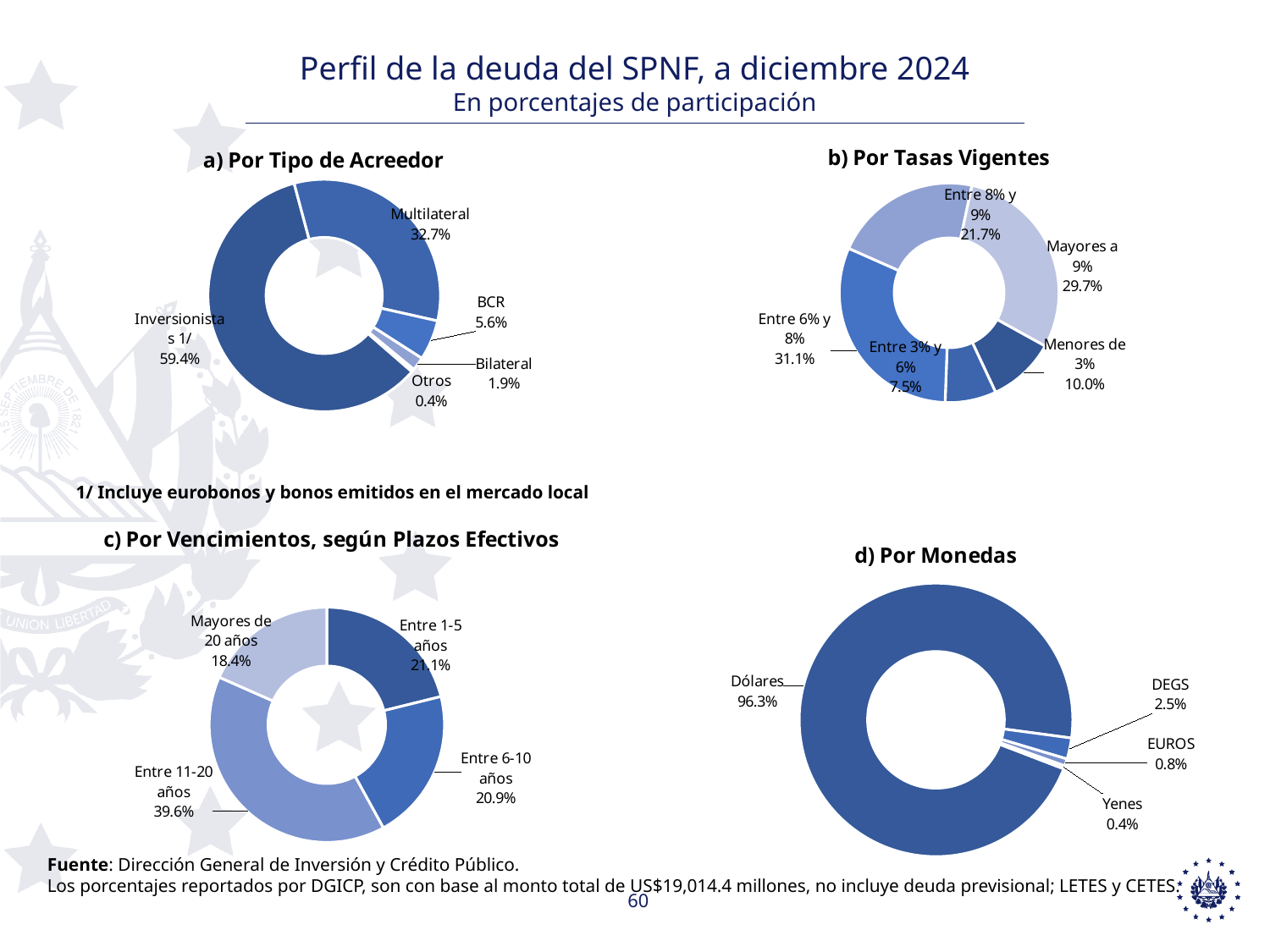
In the chart 'd) Por Monedas', what share do Dólares have? 96.3% In the chart 'a) Por Tipo de Acreedor', what is the difference between the BCR share and the Bilateral share? 3.7% In the chart 'a) Por Tipo de Acreedor', which category has the largest share? Inversionistas 1/ In the chart 'b) Por Tasas Vigentes', which is larger: 'Mayores a 9%' or 'Entre 8% y 9%'? Mayores a 9% In the chart 'b) Por Tasas Vigentes', how many categories are shown? 5 In the chart 'a) Por Tipo de Acreedor', which category has the smallest share? Otros In the chart 'a) Por Tipo de Acreedor', what share does Multilateral have? 32.7% In the chart 'c) Por Vencimientos, según Plazos Efectivos', what share corresponds to 'Entre 11-20 años'? 39.6% In the chart 'b) Por Tasas Vigentes', what share corresponds to 'Entre 6% y 8%'? 31.1% In the chart 'd) Por Monedas', what is the difference between the DEGS share and the EUROS share? 1.7% What type of chart is 'd) Por Monedas'? Donut (pie) chart In the chart 'c) Por Vencimientos, según Plazos Efectivos', which category has the smallest share? Mayores de 20 años